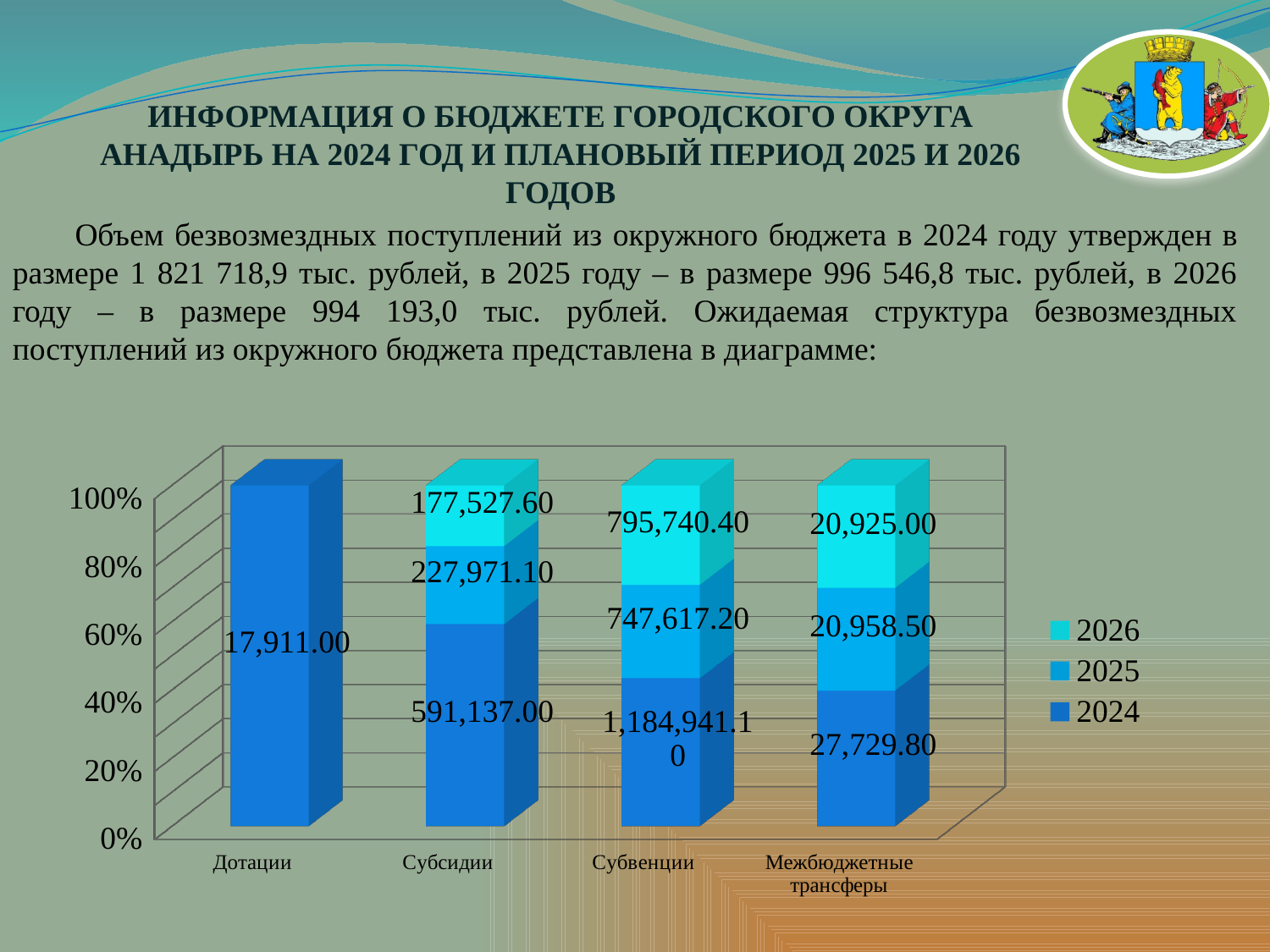
What is the 2026 value for Субсидии? 177,527.60 What is the 2024 value for Субсидии? 591,137.00 Which is larger: the 2025 value for Субсидии or the 2025 value for Межбюджетные трансферы? Субсидии (227,971.10) What is the 2024 value for Дотации? 17,911.00 Which category has the highest 2024 value? Субвенции What is the difference between the 2026 and 2025 values for Субвенции? 48,123.20 What is the 2025 value for Межбюджетные трансферы? 20,958.50 How many series does the legend list? 3 Which category has the lowest 2024 value? Дотации How many categories are shown on the x axis? 4 What is the 2026 value for Субвенции? 795,740.40 What kind of chart is shown on the slide? Stacked bar chart